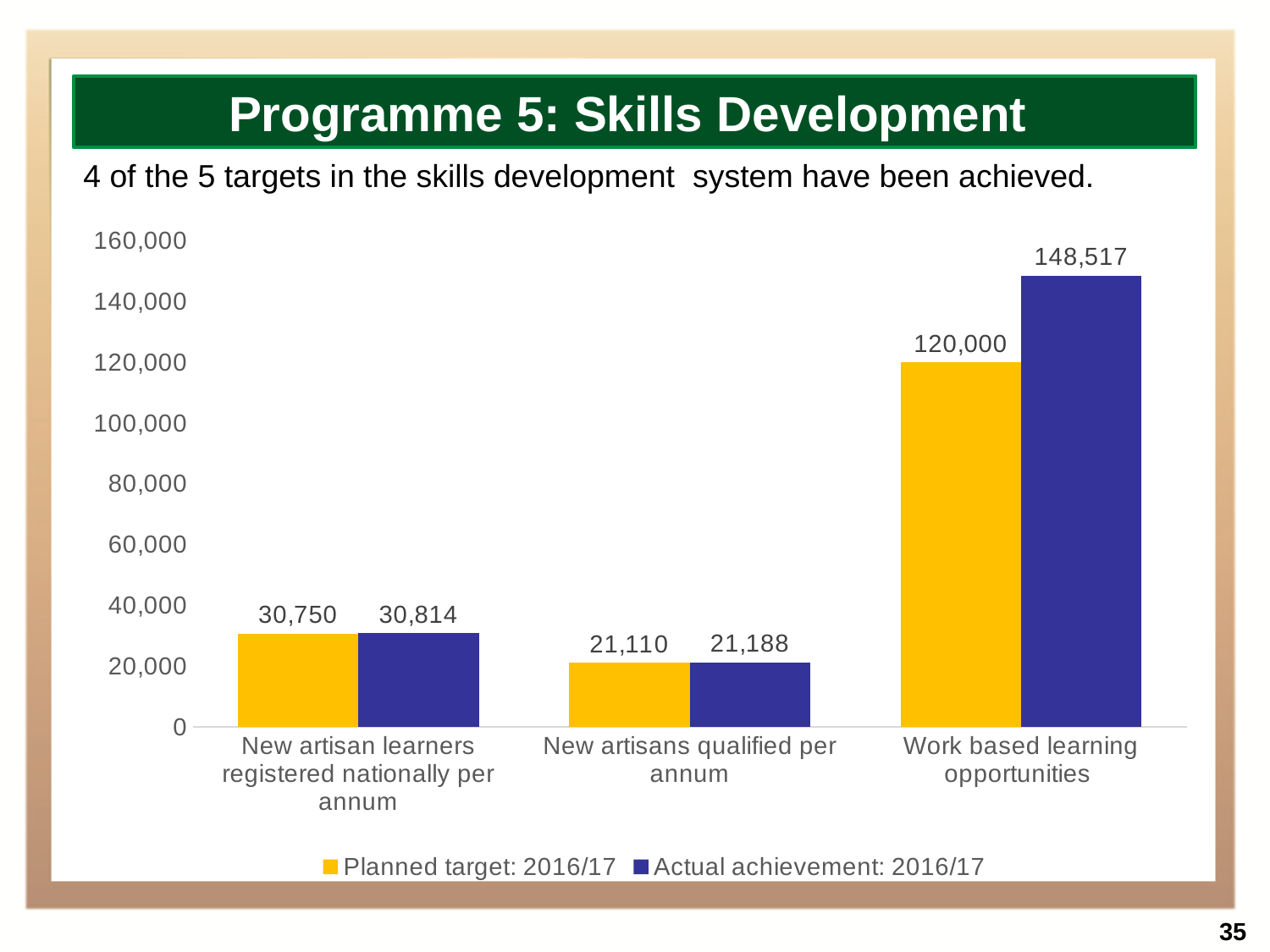
What is the actual achievement for 2016/17 for New artisan learners registered nationally per annum? 30,814 What is the difference between the actual achievement and the planned target for New artisan learners registered nationally per annum? 64 Which category has the lowest planned target for 2016/17? New artisans qualified per annum Which category has the highest actual achievement for 2016/17? Work based learning opportunities How many categories are shown on the x axis? 3 What is the planned target for 2016/17 for Work based learning opportunities? 120,000 Is the planned target for New artisan learners registered nationally per annum greater or less than 40,000? less Which colour represents the Planned target: 2016/17 series? yellow What is the difference between the actual achievement and the planned target for Work based learning opportunities? 28,517 How many series does the legend list? 2 What is the actual achievement for 2016/17 for New artisans qualified per annum? 21,188 What kind of chart is shown on the slide? bar chart